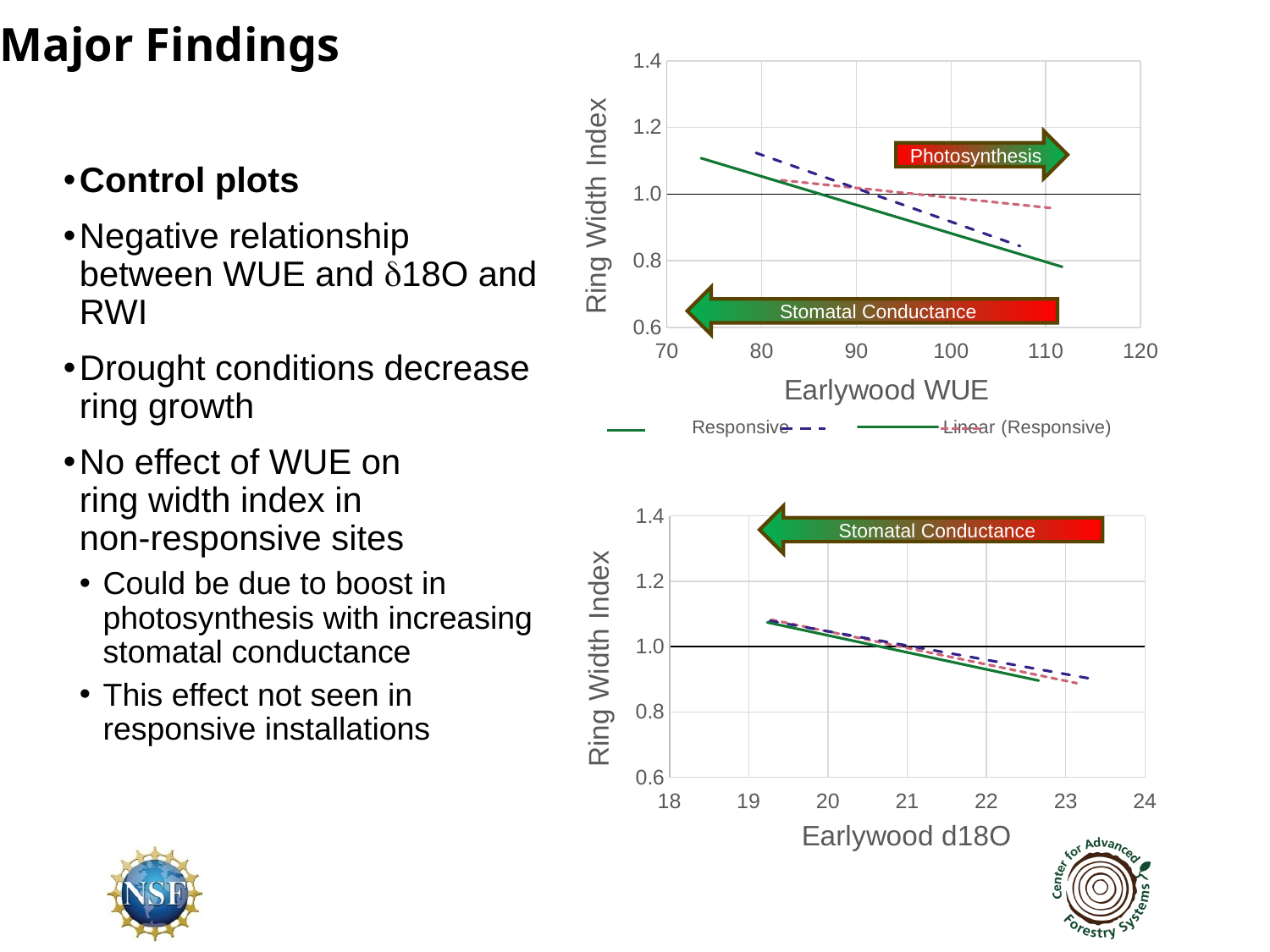
In the bottom chart, what is the title of the x axis? Earlywood d18O What kind of chart is the top chart on the slide? line chart In the bottom chart, is the value of the solid green line at an Earlywood d18O of 22 greater or less than 1.0? less In the bottom chart, do the plotted lines rise or fall as Earlywood d18O increases? fall In the bottom chart, is the value of the blue dashed line at an Earlywood d18O of 19.5 greater or less than 1.0? greater What kind of chart is the bottom chart on the slide? line chart In the top chart, is the value of the blue dashed line at an Earlywood WUE of 105 greater or less than 1.0? less In the top chart, what is the title of the x axis? Earlywood WUE In the top chart, what is the highest value shown on the y axis? 1.4 In the top chart, do the plotted lines rise or fall as Earlywood WUE increases? fall